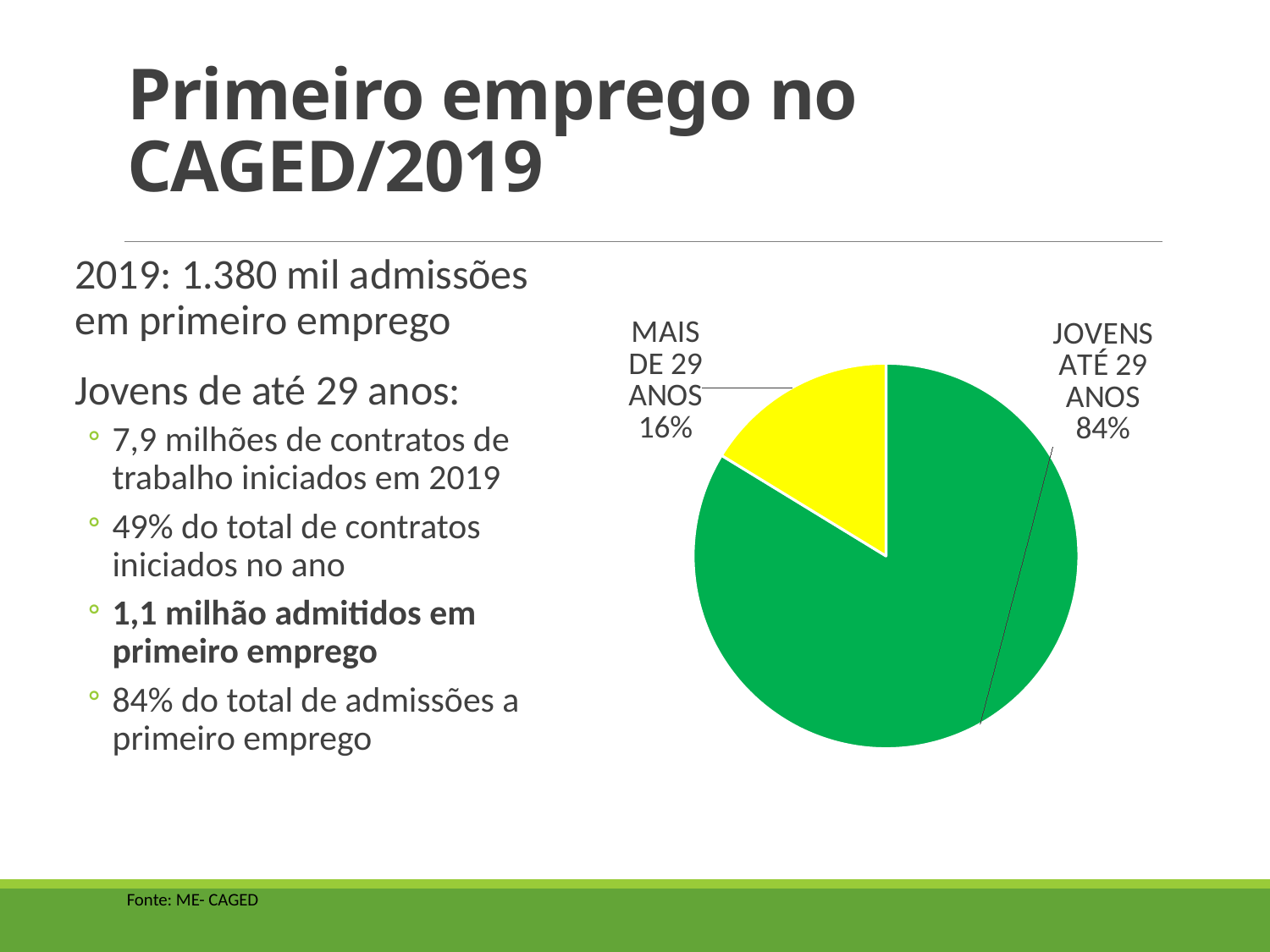
How many slices does the pie chart have? 2 What kind of chart is shown on the slide? pie chart Which slice of the pie chart is the smallest? MAIS DE 29 ANOS What colour is the slice labelled JOVENS ATÉ 29 ANOS? green Which is larger, the JOVENS ATÉ 29 ANOS slice or the MAIS DE 29 ANOS slice? JOVENS ATÉ 29 ANOS Which slice of the pie chart is the largest? JOVENS ATÉ 29 ANOS What colour is the slice labelled MAIS DE 29 ANOS? yellow What share of the pie does the slice labelled JOVENS ATÉ 29 ANOS represent? 84% What is the difference in percentage points between the JOVENS ATÉ 29 ANOS slice and the MAIS DE 29 ANOS slice? 68 percentage points What is the total of the two percentages shown on the pie chart? 100% What share of the pie does the slice labelled MAIS DE 29 ANOS represent? 16%